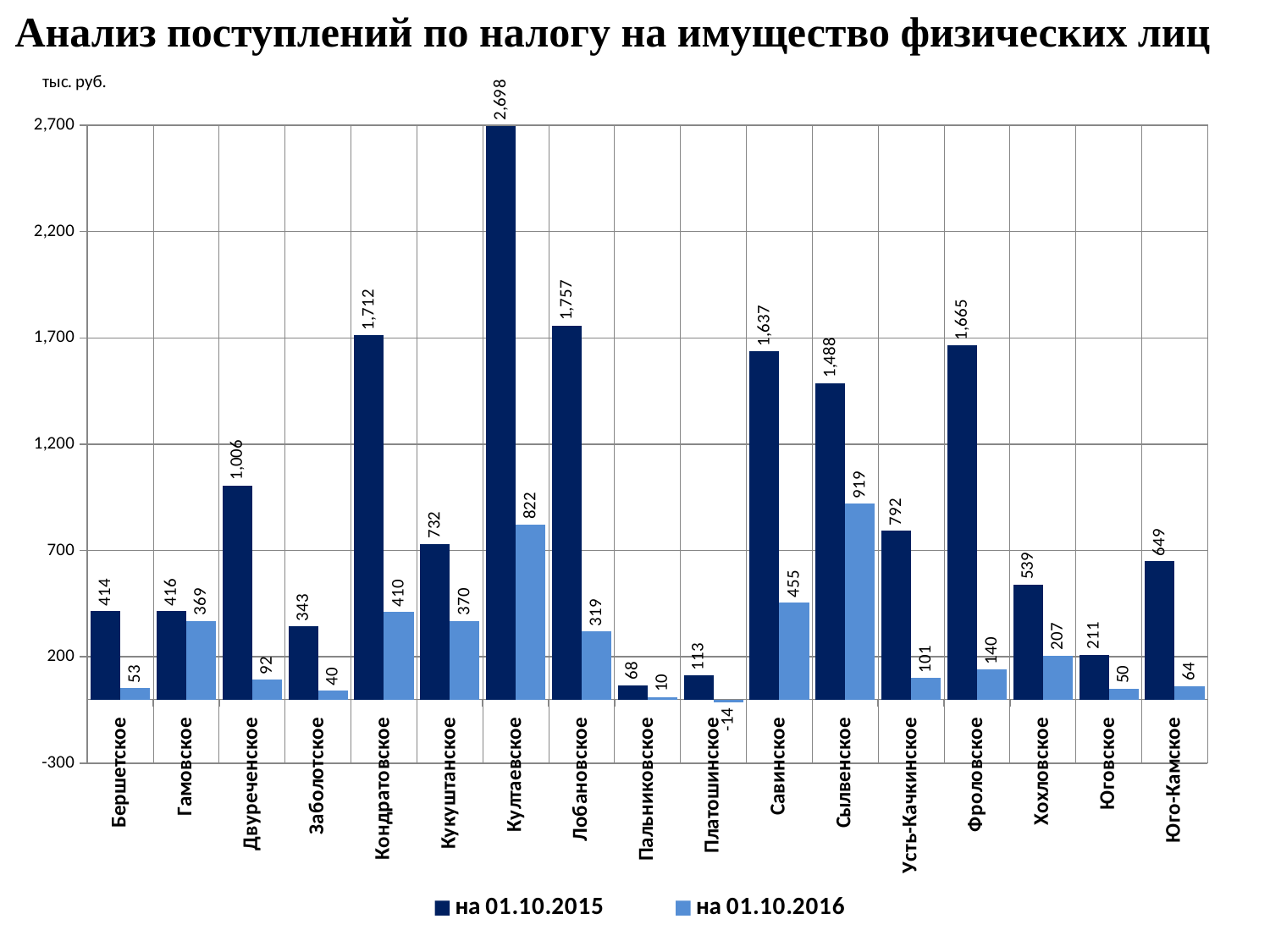
What is the value for Платошинское in the series на 01.10.2016? -14 Which category has the highest value in the series на 01.10.2016? Сылвенское Which category has the lowest value in the series на 01.10.2016? Платошинское Which is larger: the на 01.10.2016 value for Савинское or for Кондратовское? Савинское How many series does the legend list? 2 What kind of chart is shown on the slide? Bar chart What is the value for Сылвенское in the series на 01.10.2016? 919 How many categories are shown on the x axis? 17 What unit is indicated above the vertical axis? тыс. руб.